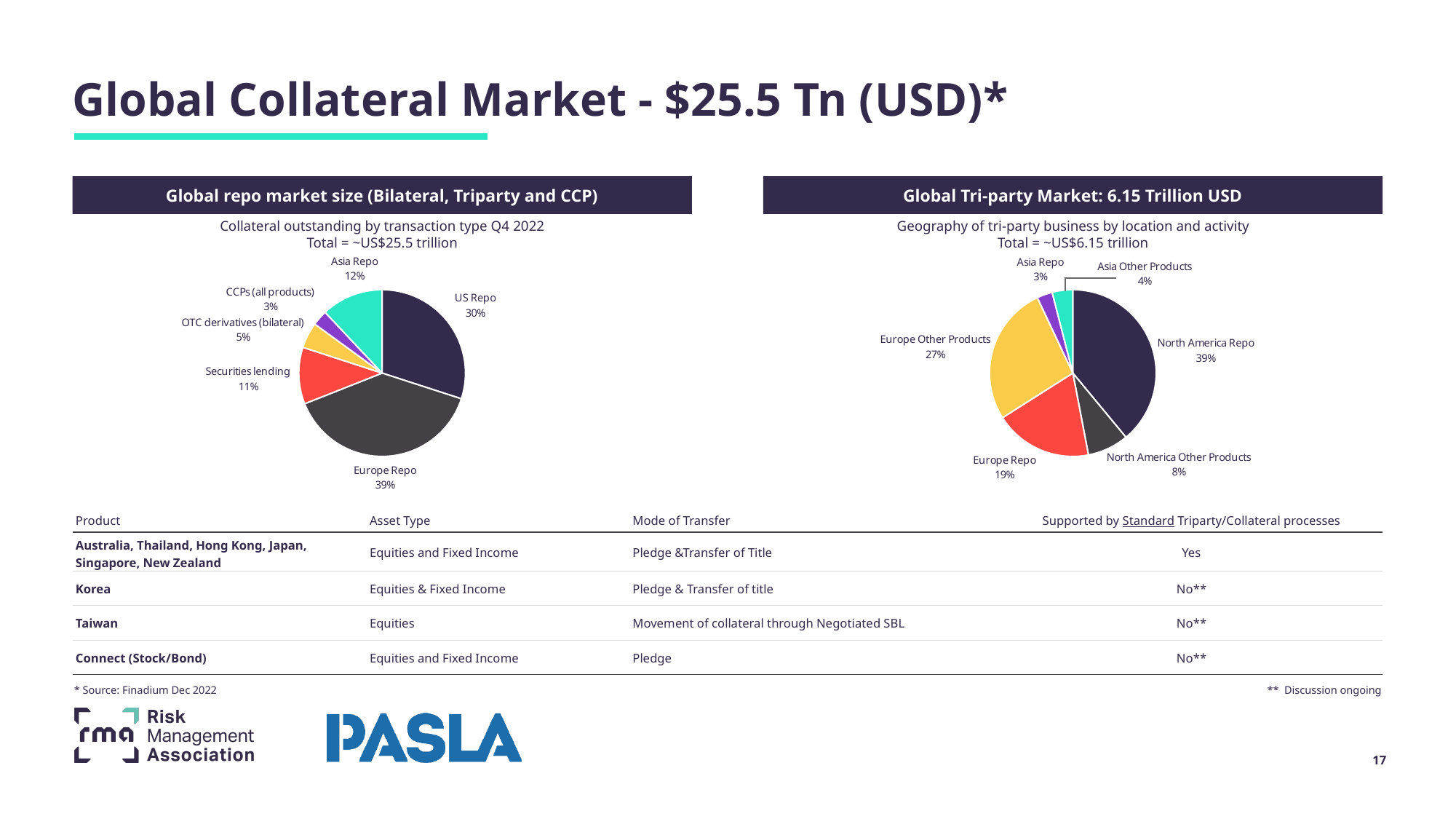
What total is stated in the subtitle of the right chart (Global Tri-party Market)? ~US$6.15 trillion In the left pie chart (Global repo market size), what is the difference in percentage points between US Repo and Asia Repo? 18 In the right pie chart (Global Tri-party Market), which category has the smallest share? Asia Repo In the right pie chart (Global Tri-party Market), what share does Europe Other Products have? 27% In the left pie chart (Global repo market size), how many slices does the pie have? 6 In the right pie chart (Global Tri-party Market), what is the difference in percentage points between Europe Repo and North America Other Products? 11 In the left pie chart (Global repo market size), which is larger, OTC derivatives (bilateral) or Asia Repo? Asia Repo In the left pie chart (Global repo market size), which category has the smallest share? CCPs (all products) In the left pie chart (Global repo market size), what share does Securities lending have? 11% What type of chart is used on the right side of the slide (Global Tri-party Market)? Pie chart In the right pie chart (Global Tri-party Market), which category has the largest share? North America Repo In the left pie chart (Global repo market size), what share does Europe Repo have? 39%